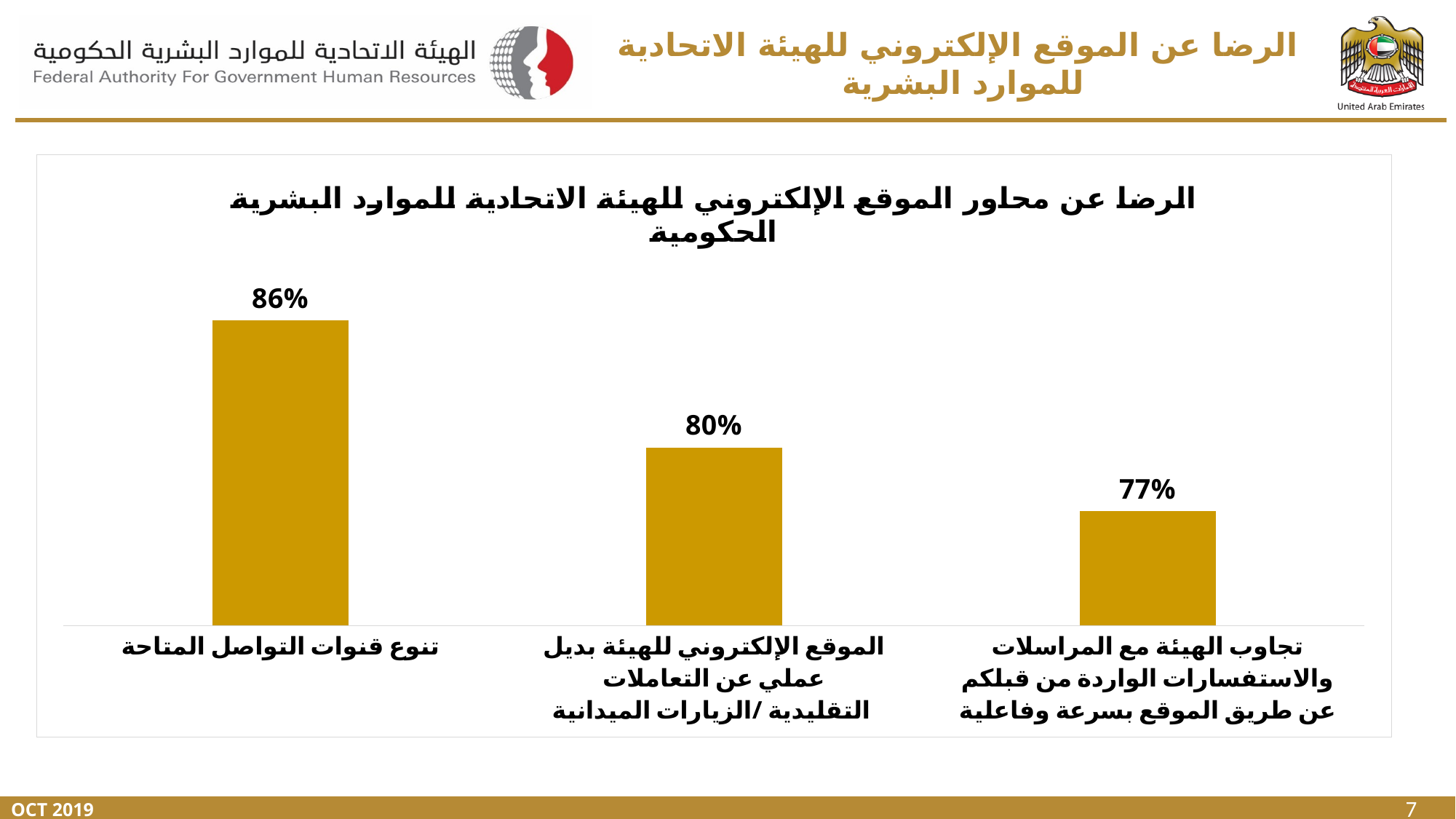
How many categories are shown in the chart? 3 What is the difference between the value for تنوع قنوات التواصل المتاحة and the value for الموقع الإلكتروني للهيئة بديل عملي عن التعاملات التقليدية /الزيارات الميدانية? 6% Which category has the lowest value? تجاوب الهيئة مع المراسلات والاستفسارات الواردة من قبلكم عن طريق الموقع بسرعة وفاعلية What is the value for تجاوب الهيئة مع المراسلات والاستفسارات الواردة من قبلكم عن طريق الموقع بسرعة وفاعلية? 77% Which category has the highest value? تنوع قنوات التواصل المتاحة What kind of chart is shown on the slide? Bar chart What is the value for تنوع قنوات التواصل المتاحة? 86% What is the title of the chart? الرضا عن محاور الموقع الإلكتروني للهيئة الاتحادية للموارد البشرية الحكومية Do the values rise or fall from left to right across the chart? Fall Which is larger: the value for الموقع الإلكتروني للهيئة بديل عملي عن التعاملات التقليدية /الزيارات الميدانية or the value for تجاوب الهيئة مع المراسلات والاستفسارات الواردة من قبلكم عن طريق الموقع بسرعة وفاعلية? الموقع الإلكتروني للهيئة بديل عملي عن التعاملات التقليدية /الزيارات الميدانية What is the difference between the value for تنوع قنوات التواصل المتاحة and the value for تجاوب الهيئة مع المراسلات والاستفسارات الواردة من قبلكم عن طريق الموقع بسرعة وفاعلية? 9% What is the value for الموقع الإلكتروني للهيئة بديل عملي عن التعاملات التقليدية /الزيارات الميدانية? 80%